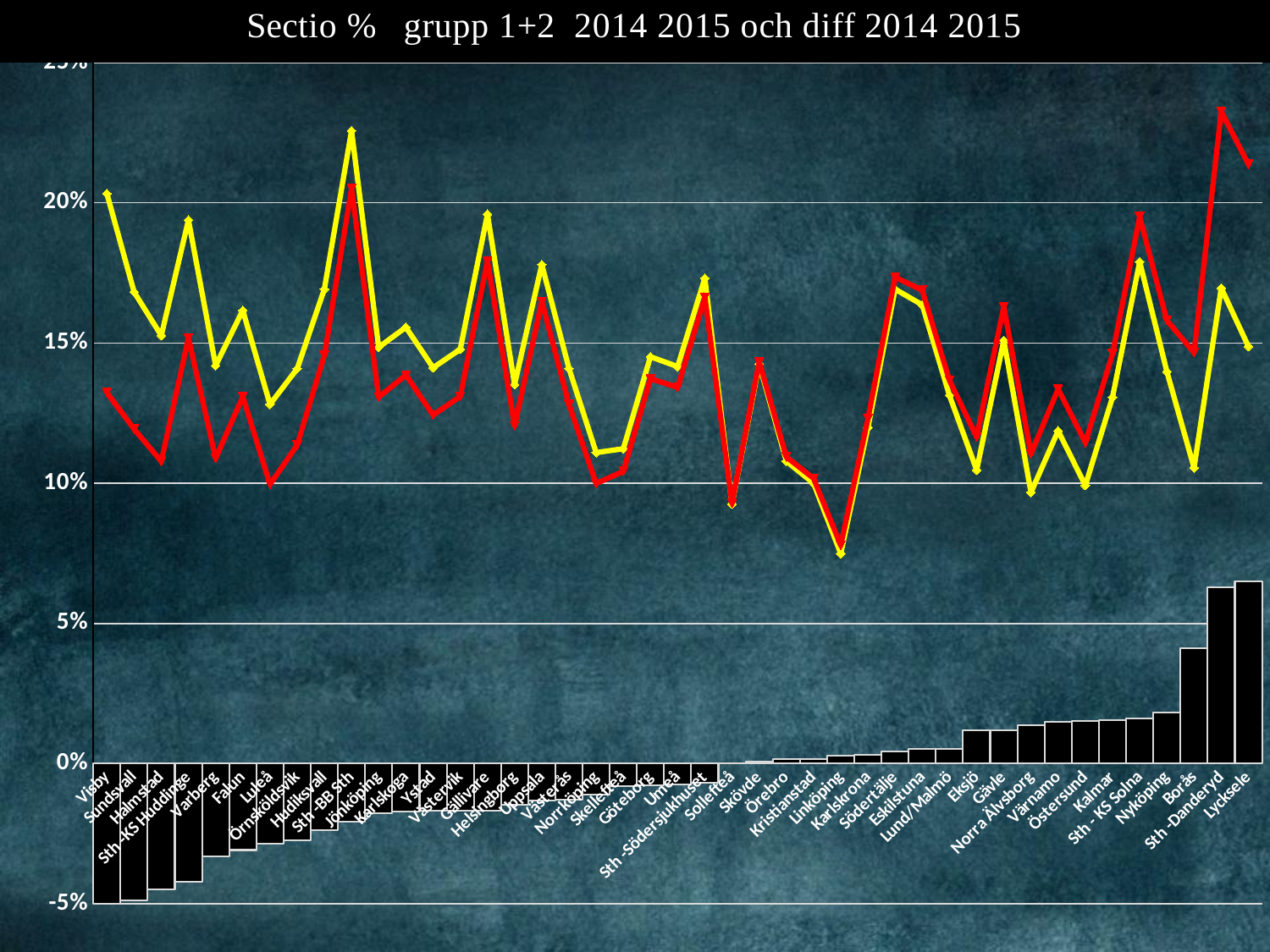
Is the yellow line's value for Linköping greater or less than 10%? less At Visby, which line has the higher value, the yellow line or the red line? The yellow line How many categories (hospitals) are shown along the x axis? 43 What colours are the two lines plotted on the chart? Yellow and red What is the title of the chart? Sectio % grupp 1+2 2014 2015 och diff 2014 2015 Is the bar value for Lycksele greater or less than 5%? greater At which category does the yellow line reach its lowest value? Linköping What kind of chart is shown on the slide? A combined line and bar chart At which category does the yellow line reach its highest value? Sth-BB Sth Do the black bars generally rise or fall from left to right along the x axis? Rise At which category does the red line reach its highest value? Sth-Danderyd Is the yellow line's value for Sth-BB Sth greater or less than 20%? greater